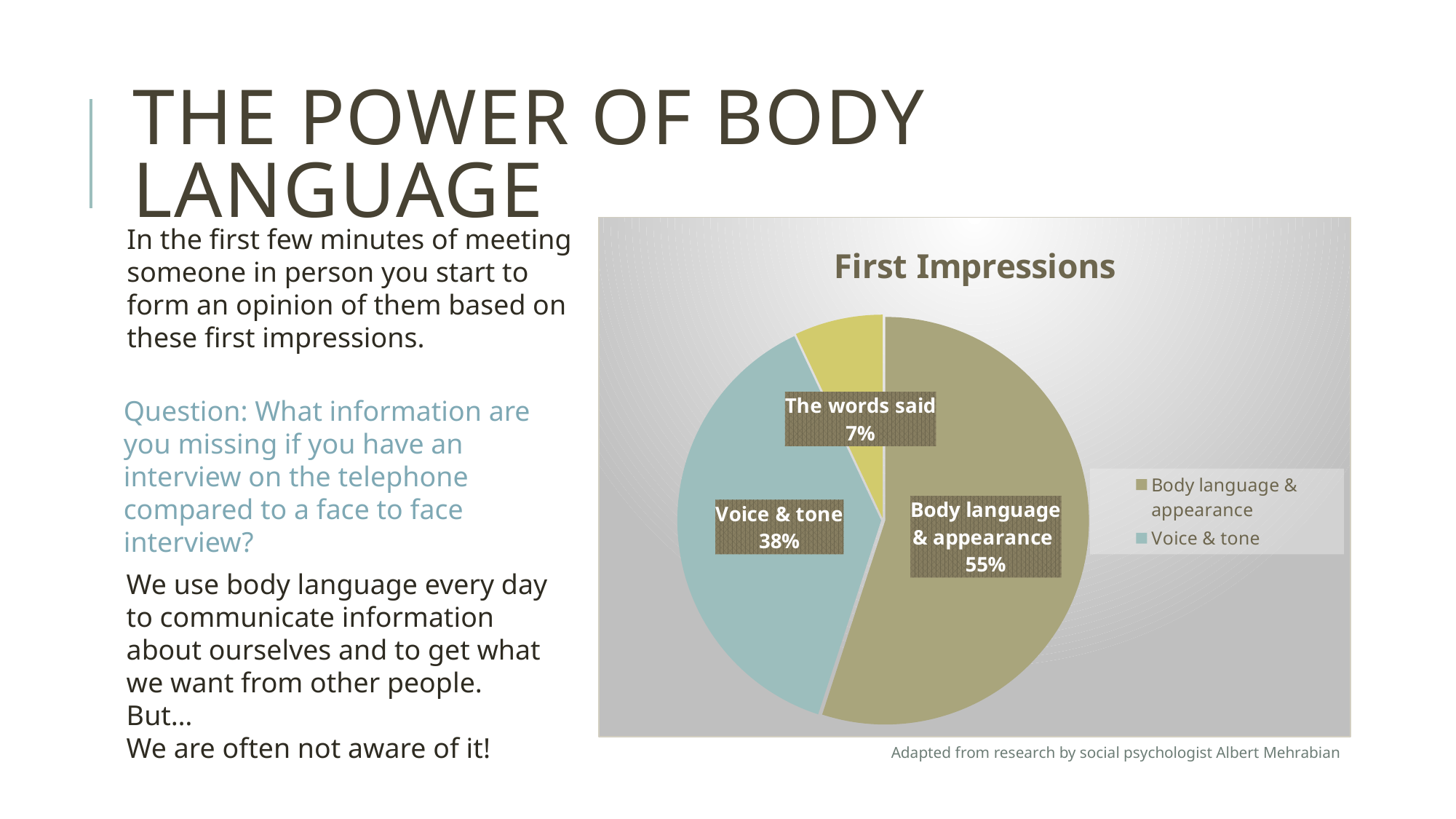
What is the difference in percentage points between Body language & appearance and Voice & tone? 17 Which slice of the pie chart is the largest? Body language & appearance What is the difference in percentage points between Voice & tone and The words said? 31 What percentage does the chart show for Voice & tone? 38% What is the title of the chart? First Impressions What type of chart is shown on the slide? pie chart Which is larger, the share for Voice & tone or the share for The words said? Voice & tone Which slice of the pie chart is the smallest? The words said What share of the pie does the Body language & appearance slice represent? 55% What percentage does the chart show for The words said? 7% How many slices does the pie chart have? 3 What percentage does the chart show for Body language & appearance? 55%